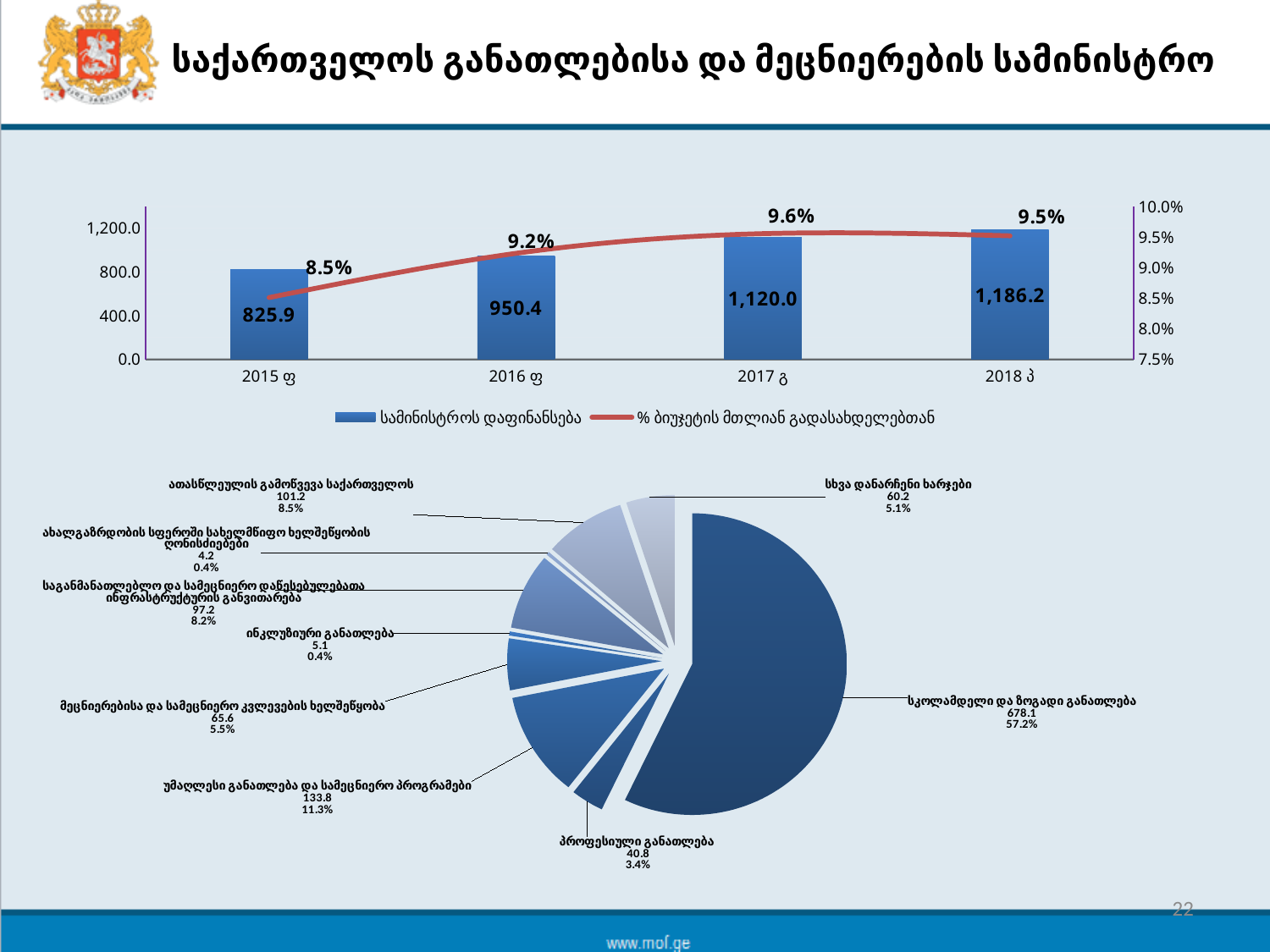
In the top chart, what is the value of the bar for 2018 პ? 1,186.2 In the top chart, do the bar values rise or fall from 2015 ფ to 2018 პ? rise How many slices does the bottom pie chart have? 9 In the top chart, what is the difference between the bar values for 2017 გ and 2016 ფ? 169.6 In the top chart, which year has the highest bar value? 2018 პ How many series does the legend of the top chart list? 2 In the bottom pie chart, what share does the slice სკოლამდელი და ზოგადი განათლება have? 57.2% In the top chart, what percentage does the line show for 2017 გ? 9.6% In the bottom pie chart, what is the value of the slice პროფესიული განათლება? 40.8 In the top chart, which year has the lowest line percentage? 2015 ფ What type of chart is the bottom chart on the slide? pie chart In the top chart, what is the value of the bar for 2015 ფ? 825.9